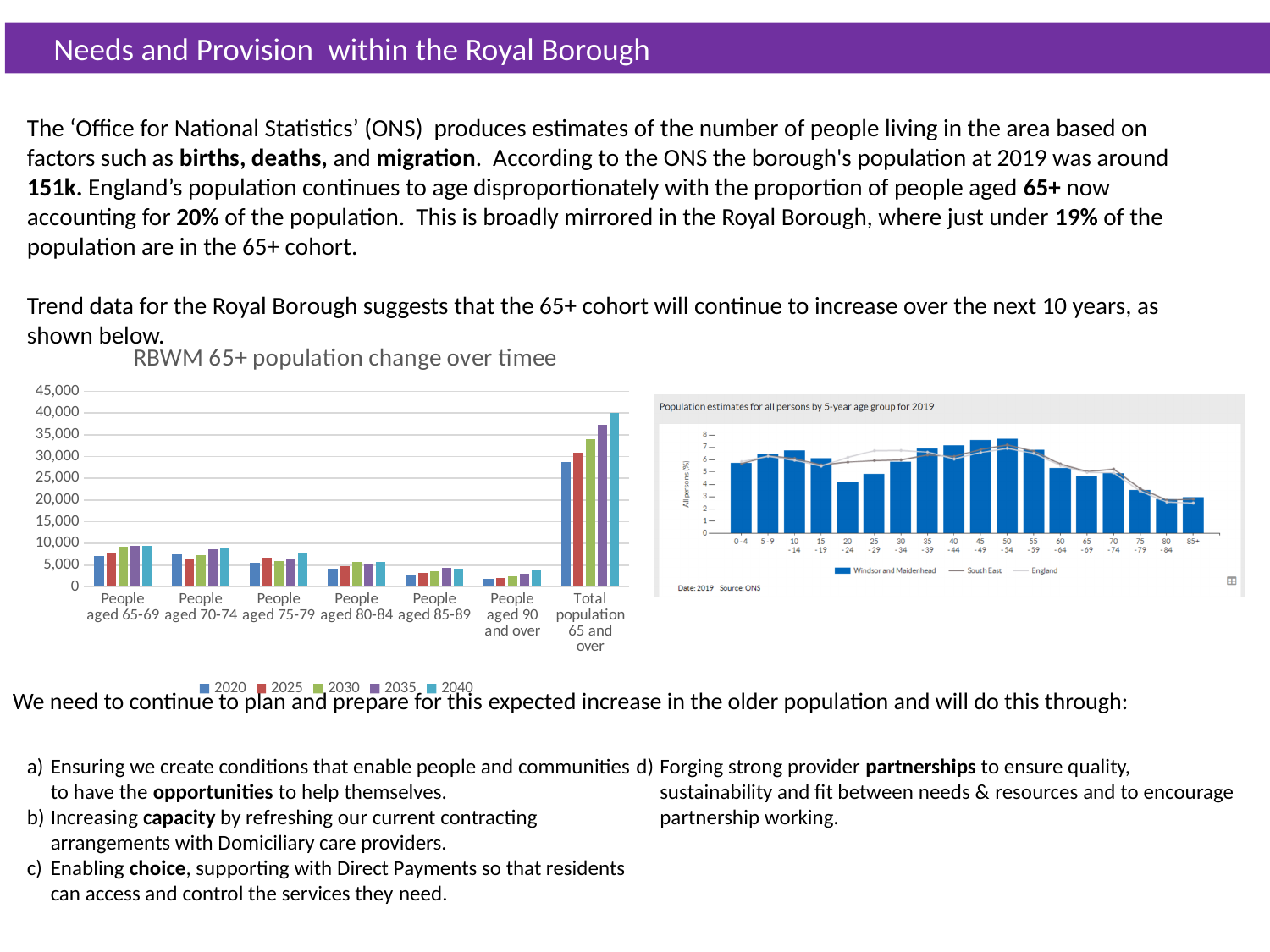
On the 'RBWM 65+ population change over timee' chart, do the values for Total population 65 and over rise or fall from 2020 to 2040? rise On the 'RBWM 65+ population change over timee' chart, which is larger in 2020: People aged 65-69 or People aged 85-89? People aged 65-69 On the 'Population estimates for all persons by 5-year age group for 2019' chart, how many age groups are shown on the x axis? 18 On the 'RBWM 65+ population change over timee' chart, which age-group category has the lowest bars? People aged 90 and over On the 'RBWM 65+ population change over timee' chart, how many series does the legend list? 5 On the 'RBWM 65+ population change over timee' chart, which category has the highest bars? Total population 65 and over On the 'Population estimates for all persons by 5-year age group for 2019' chart, how many series does the legend list? 3 On the 'RBWM 65+ population change over timee' chart, is the 2040 value for Total population 65 and over greater or less than 35,000? greater On the 'RBWM 65+ population change over timee' chart, is the 2020 value for People aged 65-69 greater or less than 10,000? less On the 'RBWM 65+ population change over timee' chart, what kind of chart is shown? bar chart On the 'RBWM 65+ population change over timee' chart, how many categories are shown on the x axis? 7 On the 'Population estimates for all persons by 5-year age group for 2019' chart, is the Windsor and Maidenhead bar for the 20-24 age group greater or less than 5? less